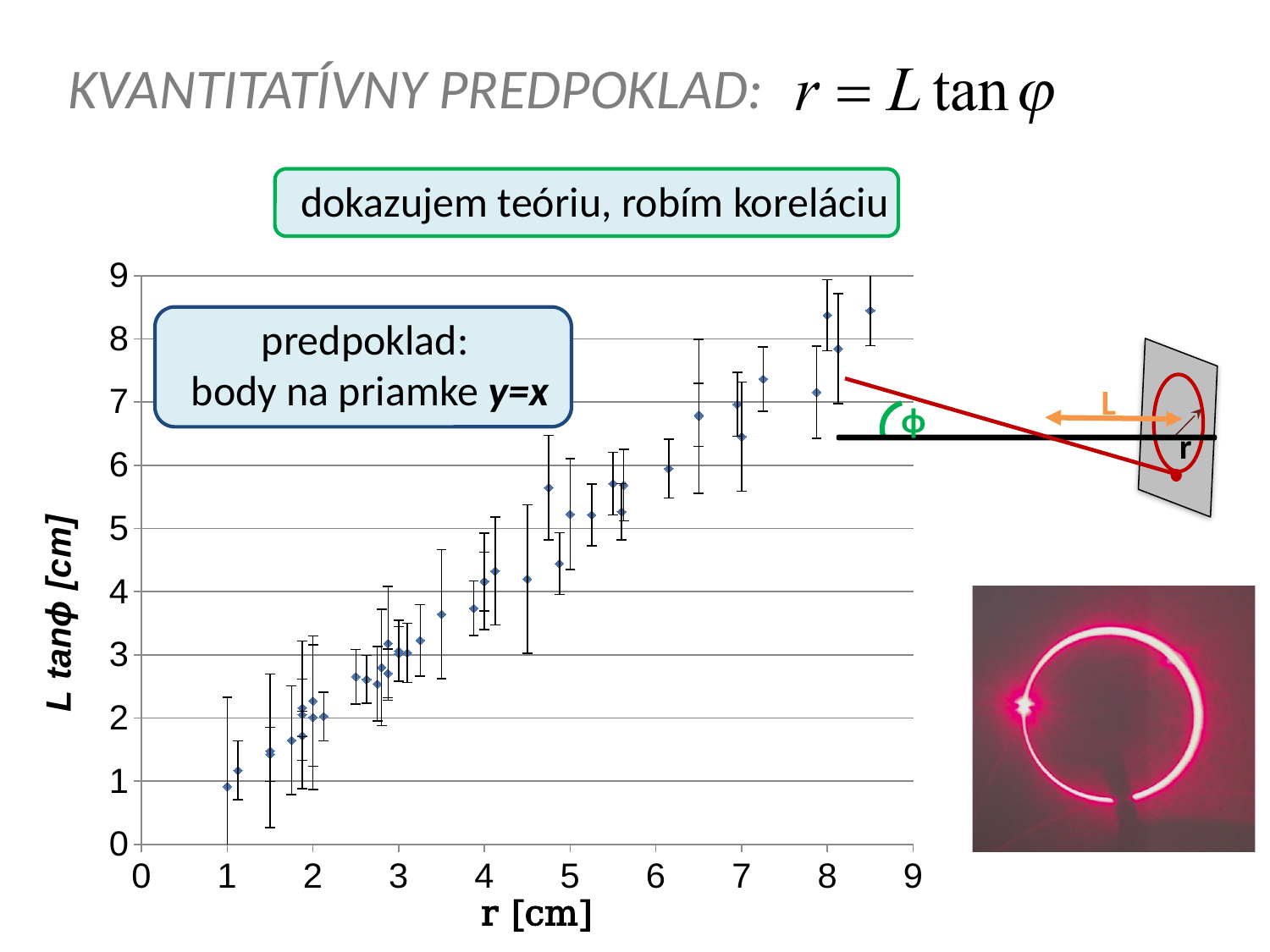
Is the value of L tanϕ for the point at r = 8.5 cm greater or less than 8? greater Do the plotted values generally rise or fall as r increases along the x axis? rise Is the value of L tanϕ for the point at r = 1 cm greater or less than 2? less Which has the larger L tanϕ value: the point at r = 1 cm or the point at r = 8.5 cm? the point at r = 8.5 cm What kind of chart is shown on the slide? scatter chart Is the value of L tanϕ for the point at r = 6.15 cm greater or less than 5? greater What is the highest tick value shown on the y axis of the chart? 9 What is the label of the y axis of the chart? L tanϕ [cm] What is the label of the x axis of the chart? r [cm]